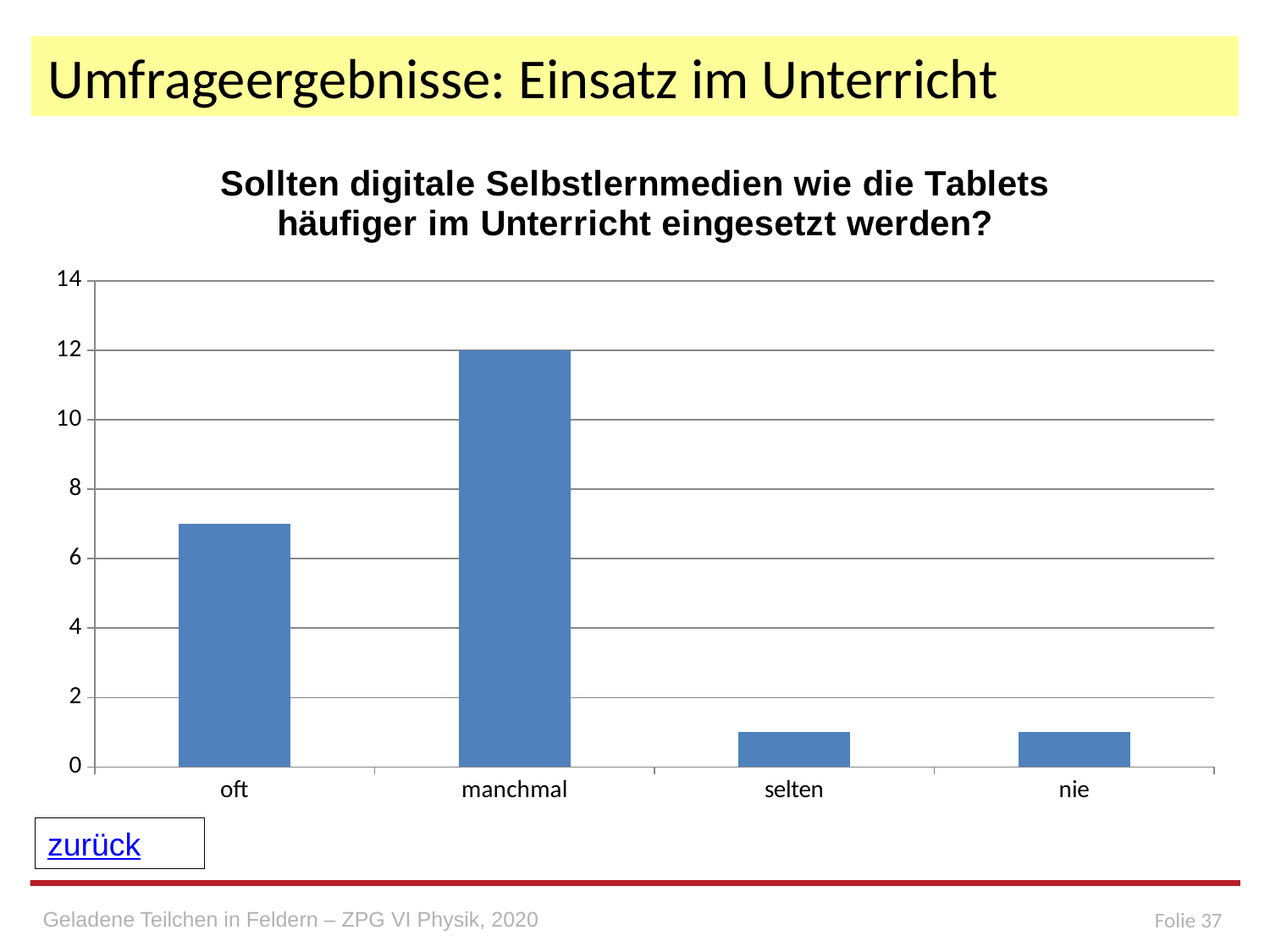
What is the highest value shown on the vertical axis of the chart? 14 How many categories are shown on the x axis of the chart? 4 What type of chart is shown on the slide? bar chart What is the value for "manchmal"? 12 Is the value for "nie" greater or less than 2? less What is the title of the chart? Sollten digitale Selbstlernmedien wie die Tablets häufiger im Unterricht eingesetzt werden? Is the value for "oft" greater or less than 8? less Which is larger, the value for "oft" or the value for "selten"? oft Is the value for "oft" greater or less than 6? greater Which is larger, the value for "oft" or the value for "manchmal"? manchmal Which category has the highest value? manchmal